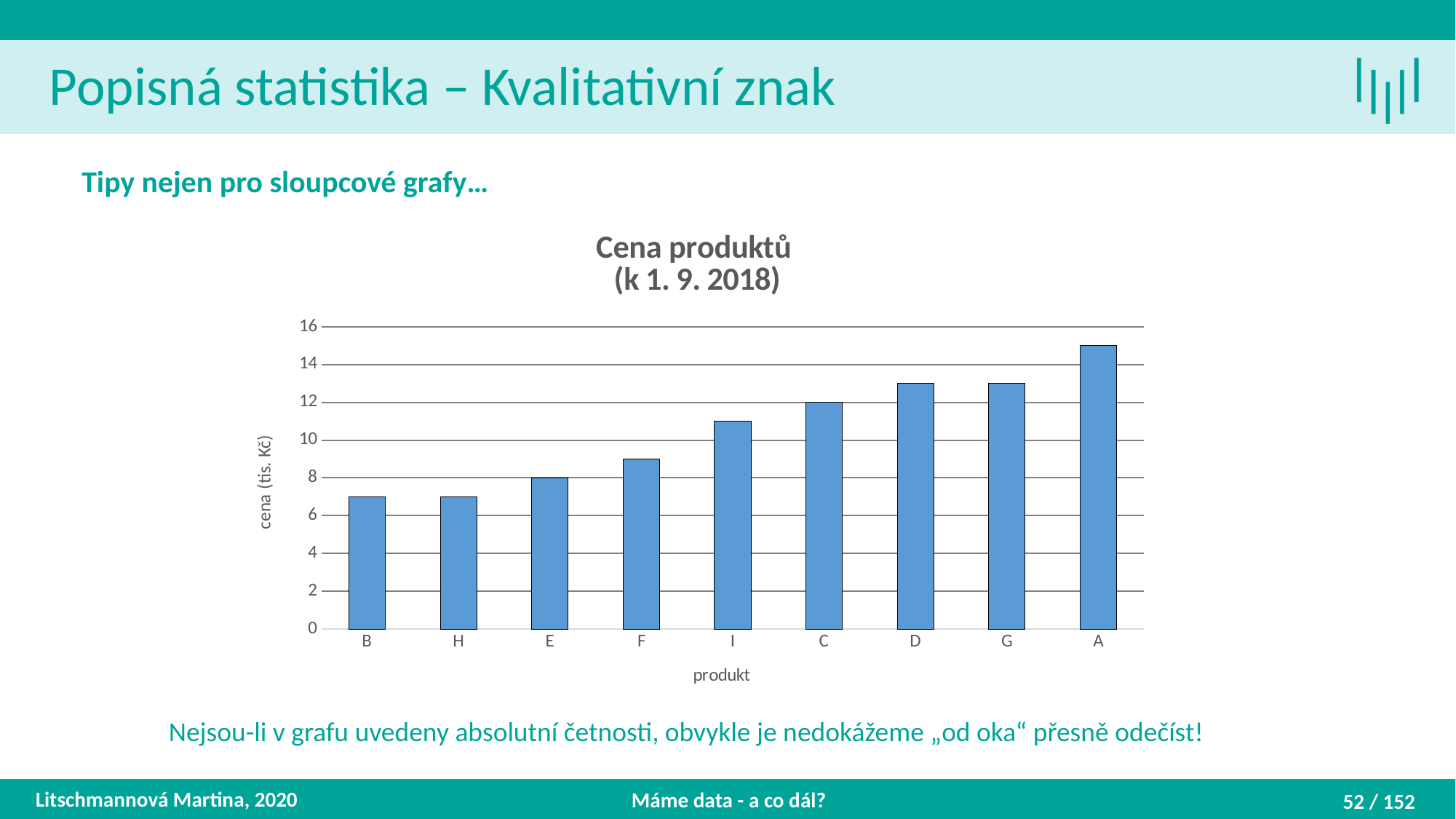
Which product has the highest price in the chart? A What kind of chart is shown on the slide? bar chart Do the values rise or fall from left to right along the x axis? rise What is the label of the vertical axis? cena (tis. Kč) What is the title of the chart? Cena produktů (k 1. 9. 2018) Is the value for product A greater or less than 14? greater How many products are shown on the x axis of the chart? 9 What is the price (tis. Kč) for product C? 12 Is the value for product B greater or less than 8? less Is the value for product I greater or less than 10? greater What is the price (tis. Kč) for product E? 8 Which is larger, the value for product D or the value for product F? D